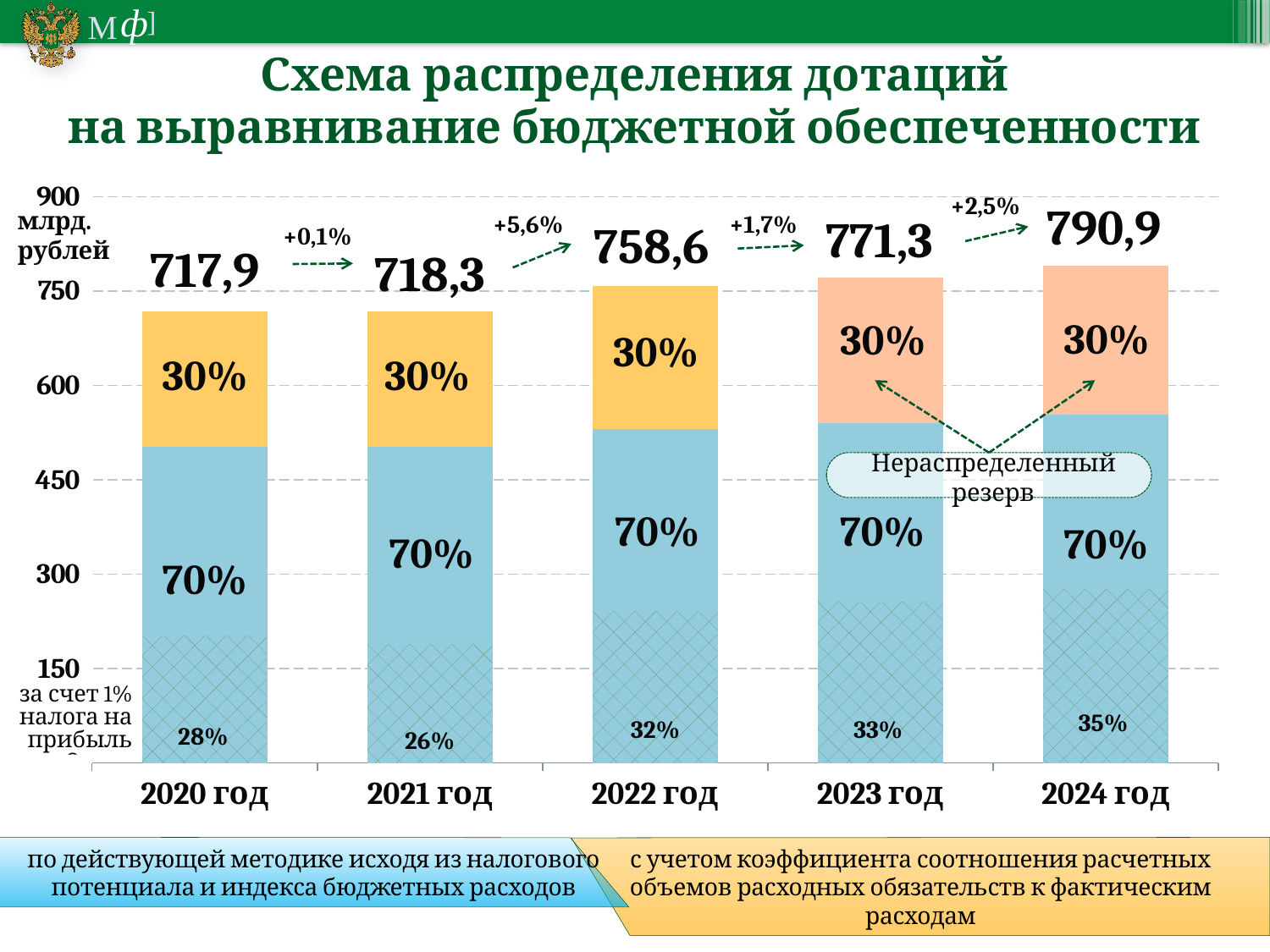
How many years (bars) are shown on the chart? 5 Do the total values rise or fall from 2020 год to 2024 год? rise Which year has the lowest total value? 2020 год What is the total value shown above the bar for 2020 год? 717,9 What label is shown in the callout pointing to the top segments of the 2023 and 2024 bars? Нераспределенный резерв Which is larger, the total for 2022 год or the total for 2021 год? 2022 год What percentage growth is shown by the arrow between 2021 год and 2022 год? +5,6% What type of chart is shown on the slide? bar chart What is the total value shown above the bar for 2024 год? 790,9 What percentage is printed in the hatched lower part of the bar for 2023 год? 33% What is the difference between the totals for 2024 год and 2023 год? 19,6 Which year has the highest total value? 2024 год